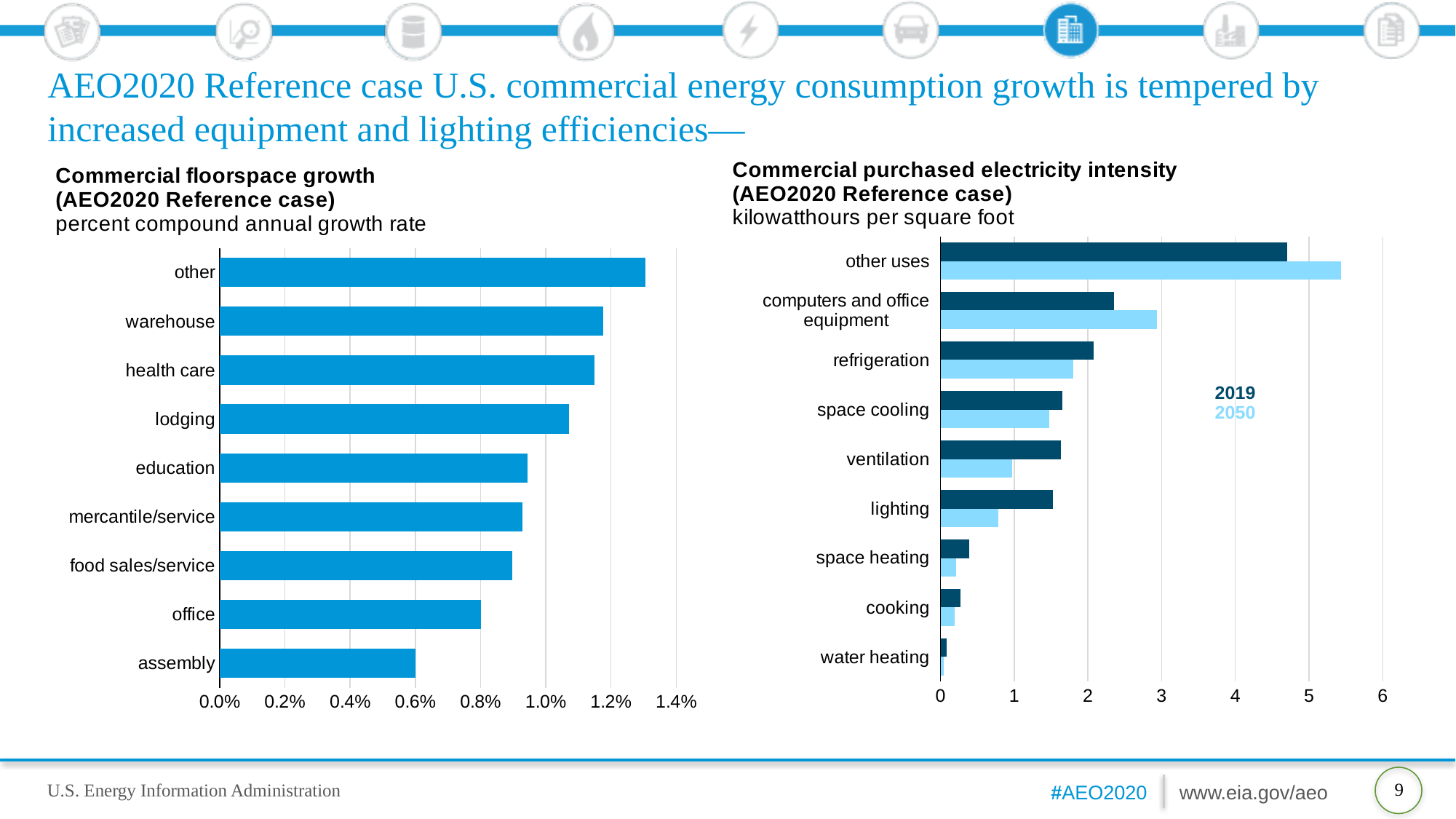
In the Commercial floorspace growth chart, which building type has the highest growth rate? other In the Commercial floorspace growth chart, what kind of chart is shown? bar chart In the Commercial floorspace growth chart, which is larger, the value for lodging or the value for office? lodging In the Commercial purchased electricity intensity chart, which is larger for lighting, the 2019 value or the 2050 value? 2019 In the Commercial purchased electricity intensity chart, which end use has the highest 2050 value? other uses In the Commercial floorspace growth chart, how many building types are plotted? 9 In the Commercial floorspace growth chart, which building type has the lowest growth rate? assembly In the Commercial purchased electricity intensity chart, how many series does the legend list? 2 In the Commercial floorspace growth chart, is the value for other greater or less than 1.2%? greater In the Commercial purchased electricity intensity chart, which end use has the lowest 2019 value? water heating In the Commercial floorspace growth chart, is the value for assembly greater or less than 0.8%? less In the Commercial purchased electricity intensity chart, is the 2050 value for other uses greater or less than 5? greater